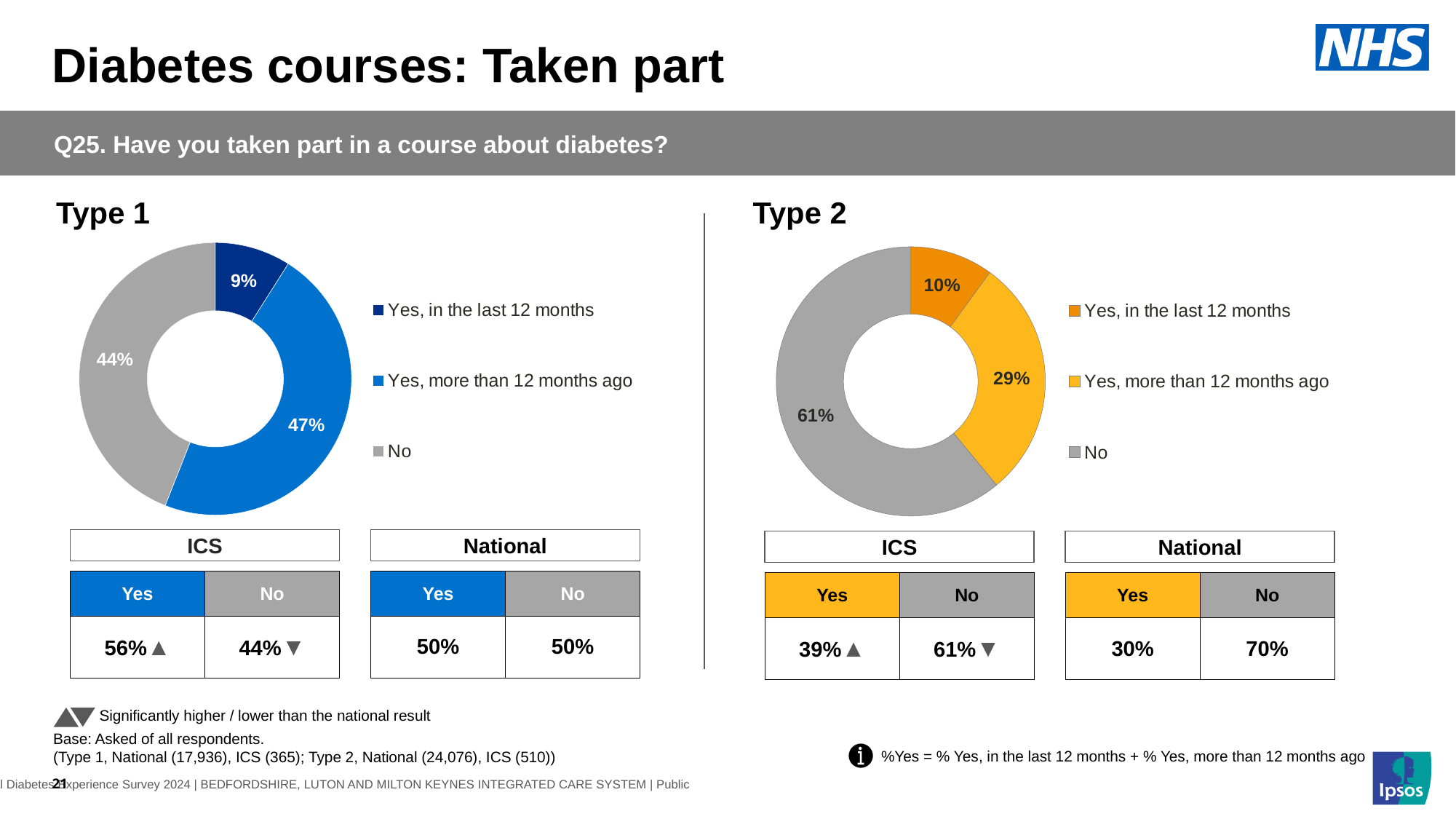
In the Type 2 chart, what is the difference in percentage points between 'No' and 'Yes, more than 12 months ago'? 32 In the Type 2 chart, what percentage of respondents said 'No'? 61% In the Type 1 chart, which is larger: 'No' or 'Yes, more than 12 months ago'? Yes, more than 12 months ago In the Type 1 chart, what percentage of respondents said 'Yes, in the last 12 months'? 9% What colour represents 'No' in the Type 2 chart? Grey In the Type 1 chart, which category has the largest share? Yes, more than 12 months ago In the Type 2 chart, which category has the smallest share? Yes, in the last 12 months How many categories does the Type 2 chart's legend list? 3 In the Type 1 chart, what is the combined percentage of the two 'Yes' categories? 56% In the Type 1 chart, what percentage of respondents said 'Yes, more than 12 months ago'? 47% What kind of chart is used for Type 1? Doughnut chart In the Type 2 chart, what percentage of respondents said 'Yes, more than 12 months ago'? 29%